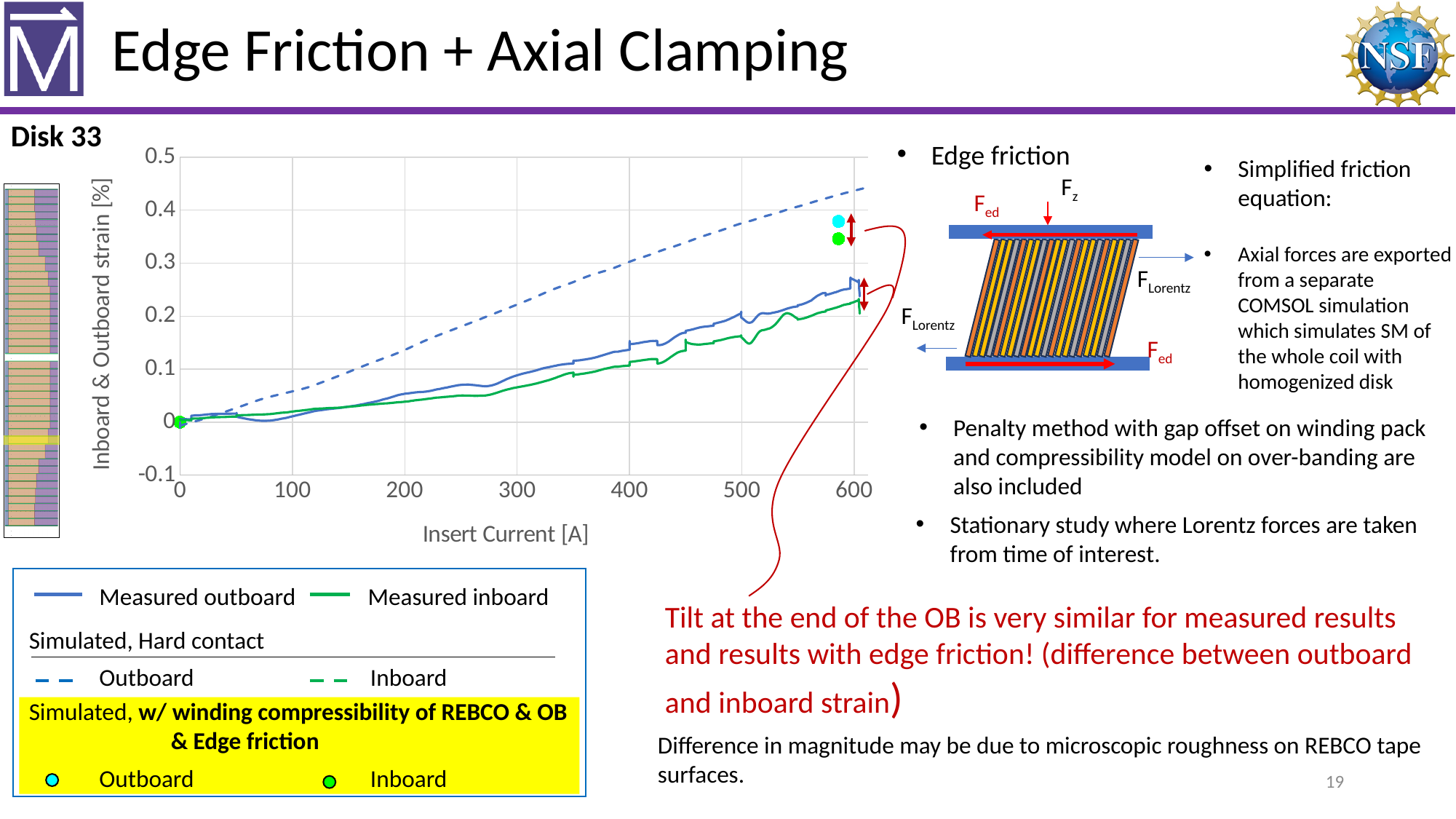
Is the Simulated w/ winding compressibility & Edge friction Inboard point greater or less than 0.3? greater At 600 A, which is larger: the Simulated, Hard contact Outboard strain or the Measured outboard strain? Simulated, Hard contact Outboard Is the Simulated, Hard contact Outboard strain at 600 A greater or less than 0.4? greater What kind of chart is shown on the slide? line chart What is the x-axis title of the chart? Insert Current [A] Which is larger: the Simulated w/ winding compressibility & Edge friction Outboard point or the Inboard point? Outboard Does the Measured outboard strain rise or fall as insert current increases? rise Is the Simulated w/ winding compressibility & Edge friction Outboard point greater or less than 0.4? less What is the y-axis title of the chart? Inboard & Outboard strain [%] How many series does the chart legend list? 6